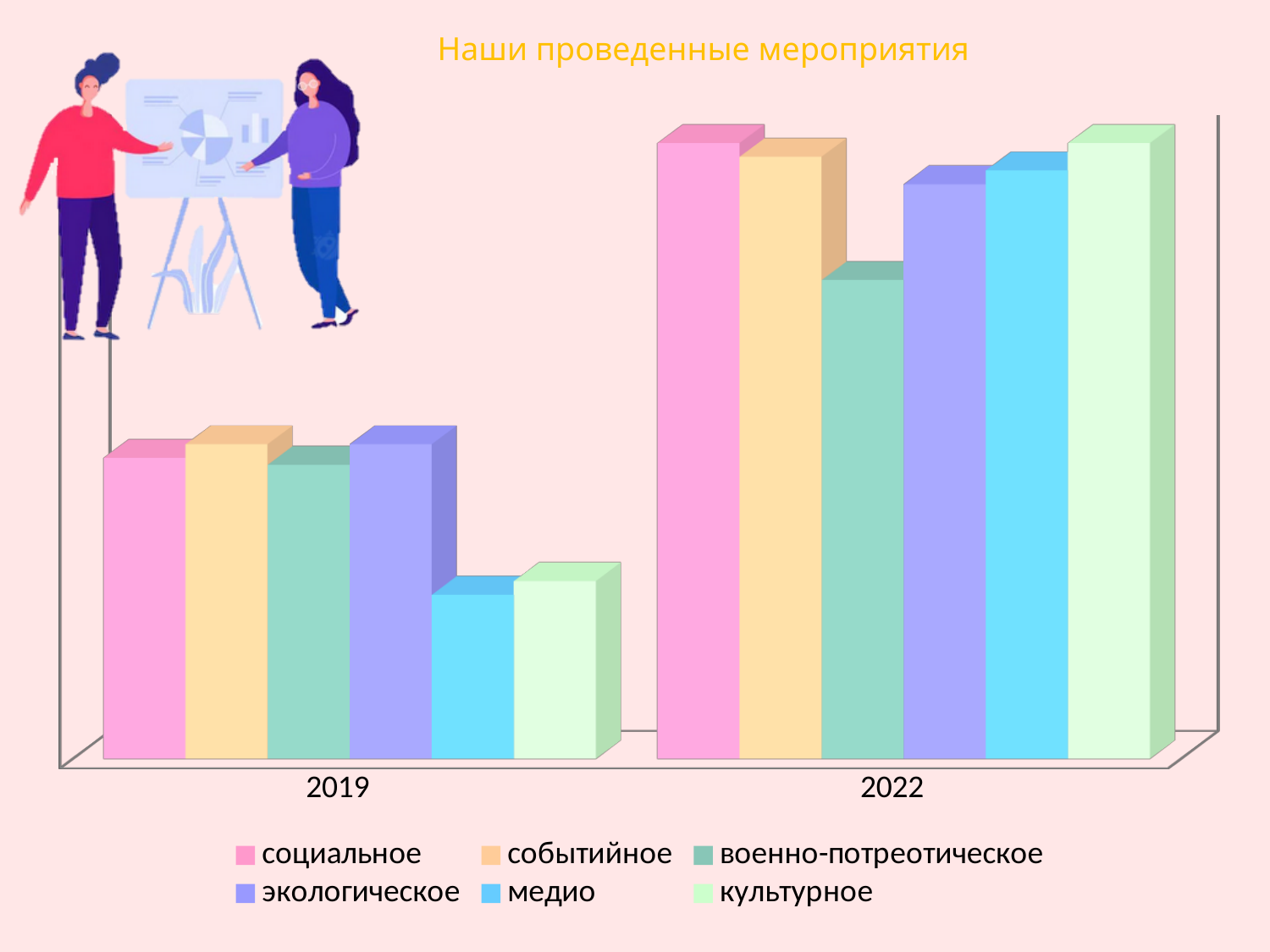
In 2019, which is larger: экологическое or культурное? экологическое How many categories are shown on the x axis? 2 In 2022, which is larger: социальное or военно-потреотическое? социальное How many series does the legend list? 6 Which legend entry is shown in pink? социальное What kind of chart is shown on the slide? bar chart In 2019, which is larger: социальное or медио? социальное What is the title of the chart? Наши проведенные мероприятия Which series has the lowest value in 2022? военно-потреотическое Which series has the lowest value in 2019? медио Does the value for медио rise or fall from 2019 to 2022? rise